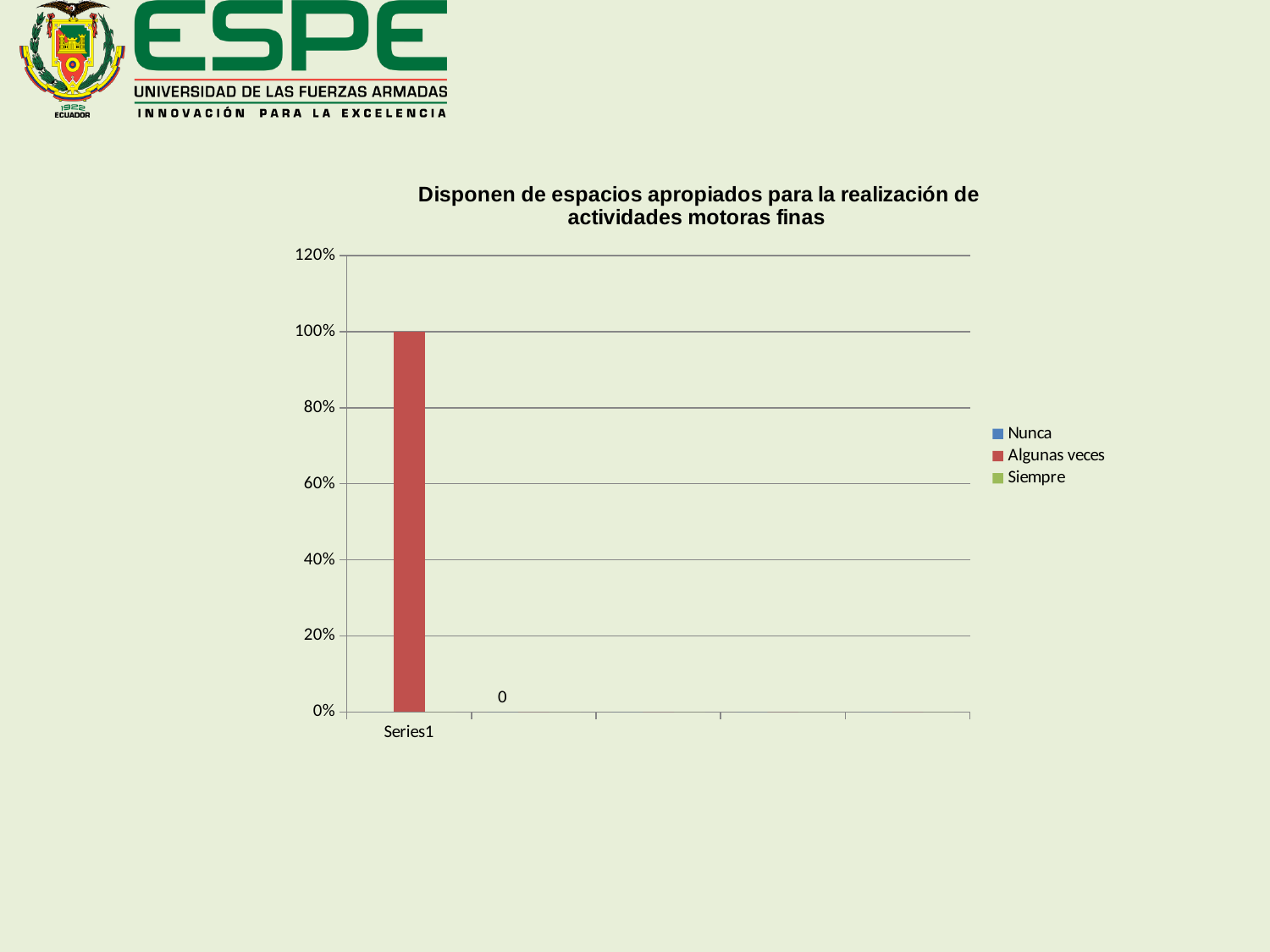
What is the highest value shown on the y axis? 120% Is the value for Algunas veces greater or less than 80%? greater What type of chart is shown on the slide? Bar chart What is the label of the category on the x axis? Series1 Which series has the highest bar in the chart? Algunas veces How many series does the legend list? 3 What are the series names listed in the legend? Nunca, Algunas veces, Siempre Which is larger, the value for Algunas veces or the value for Nunca? Algunas veces What is the value of the Algunas veces bar for Series1? 100% What is the title of the chart? Disponen de espacios apropiados para la realización de actividades motoras finas